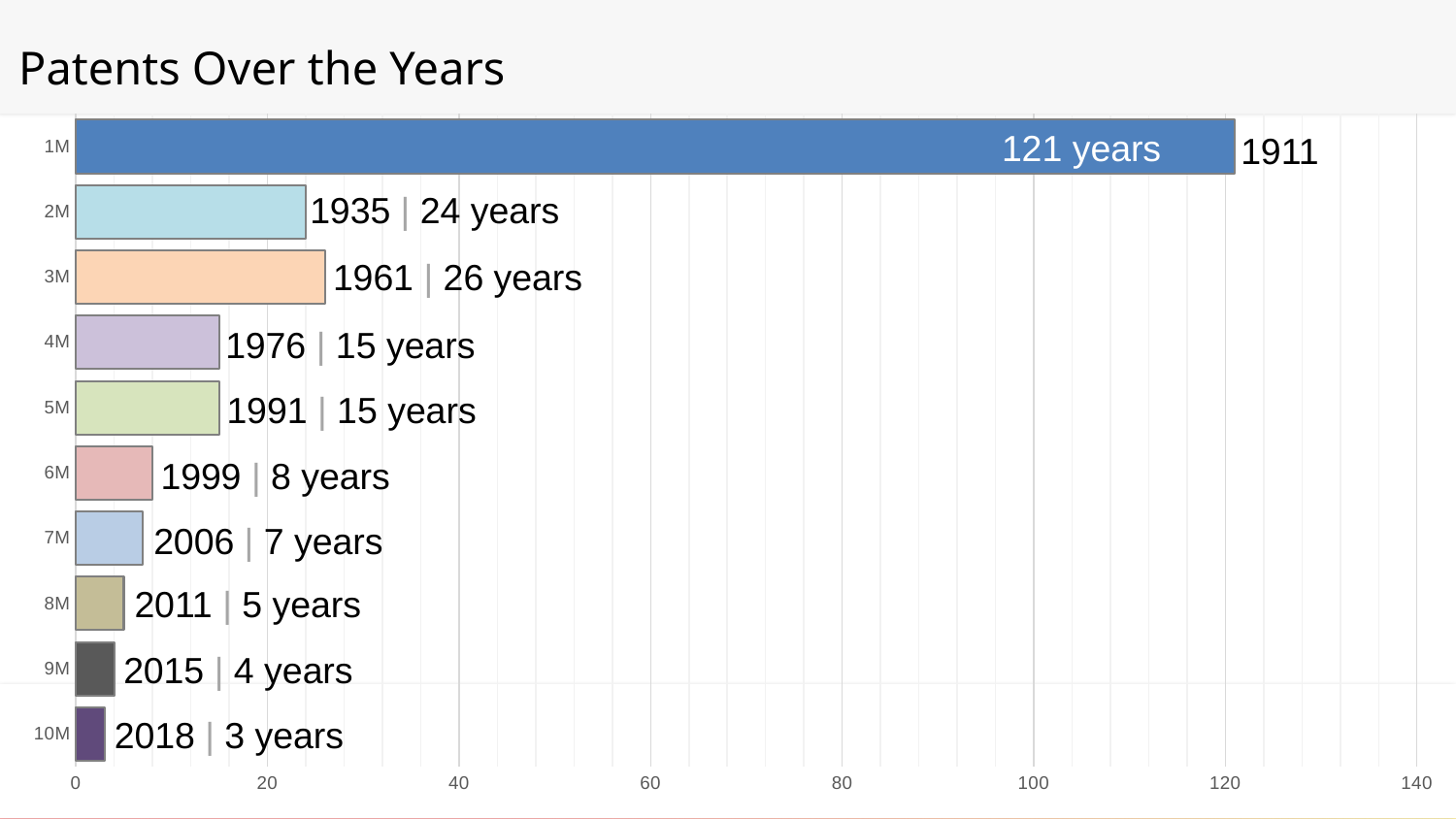
Which milestone took more years to reach, 2M or 3M? 3M How many years did it take to reach the 1M milestone? 121 years Which milestone has the highest number of years? 1M In which year was the 10M milestone reached? 2018 What kind of chart is shown on the slide? bar chart Is the value for 1M greater or less than 100? greater What is the title of the chart? Patents Over the Years What is the difference in years between the 3M and 2M milestones? 2 years In which year was the 3M milestone reached? 1961 How many categories (bars) does the chart show? 10 Which milestone has the lowest number of years? 10M How many years did it take to reach the 6M milestone? 8 years